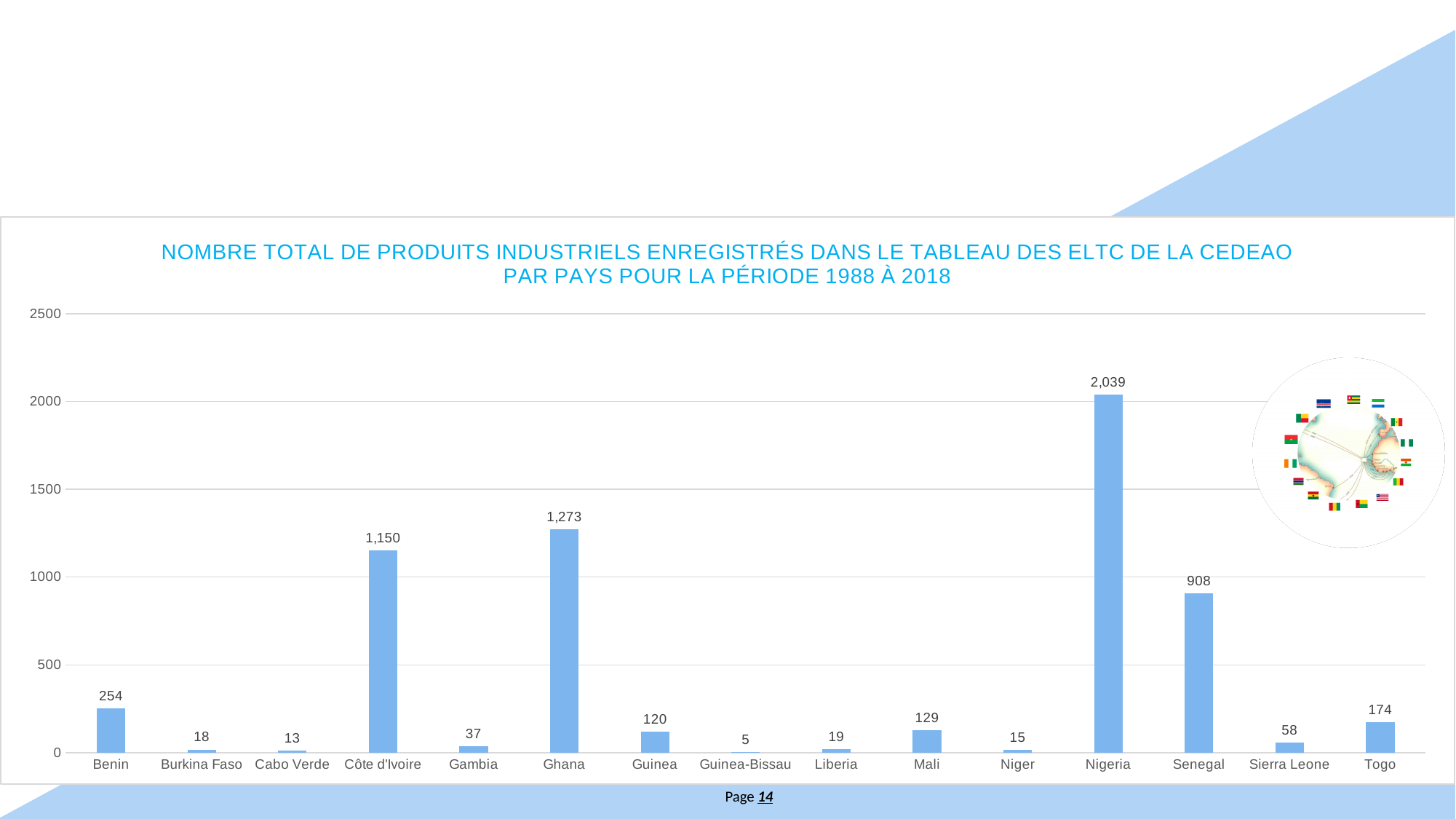
How many countries are shown on the x axis? 15 What period does the chart title say the data covers? 1988 à 2018 Which country has the lowest value? Guinea-Bissau What is the difference between the values for Nigeria and Ghana? 766 Which country has the highest value? Nigeria What is the difference between the values for Senegal and Benin? 654 What kind of chart is shown on the slide? bar chart Is the value for Senegal greater or less than 1000? less Which is larger, the value for Mali or the value for Guinea? Mali What is the value for Nigeria? 2,039 What is the value for Côte d'Ivoire? 1,150 What is the value for Guinea-Bissau? 5